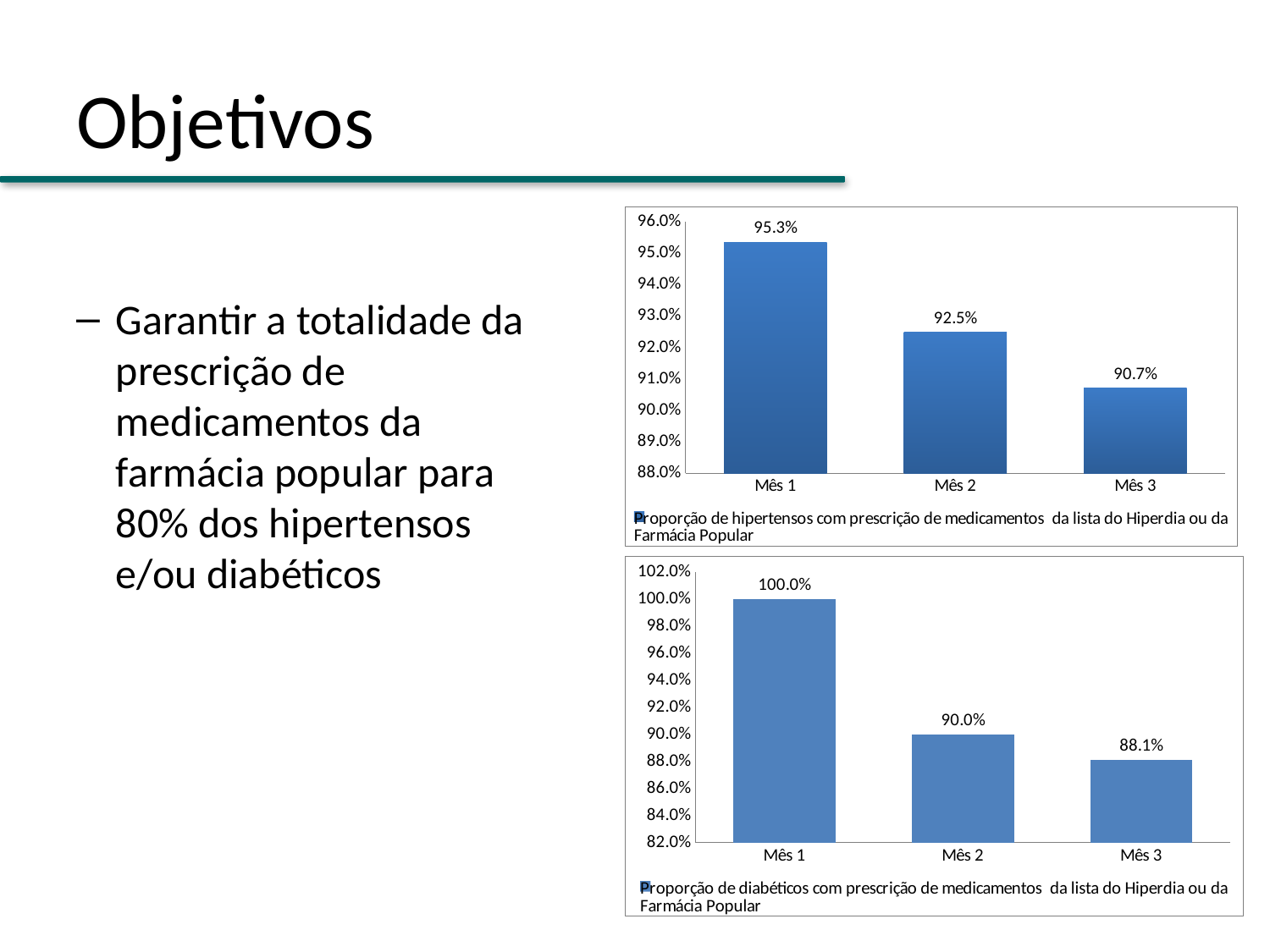
In the top chart (hipertensos), what is the value for Mês 1? 95.3% In the bottom chart (diabéticos), what is the value for Mês 2? 90.0% What kind of chart is the bottom chart (diabéticos)? bar chart In the bottom chart (diabéticos), which month has the lowest value? Mês 3 In the top chart (hipertensos), what is the value for Mês 3? 90.7% In the bottom chart (diabéticos), what is the value for Mês 3? 88.1% In the bottom chart (diabéticos), do the values rise or fall from Mês 1 to Mês 3? fall In the top chart (hipertensos), which month has the highest value? Mês 1 In the bottom chart (diabéticos), what is the difference between Mês 1 and Mês 3? 11.9% How many months are shown in the top chart (hipertensos)? 3 In the top chart (hipertensos), which is larger, Mês 2 or Mês 3? Mês 2 In the top chart (hipertensos), what is the difference between Mês 1 and Mês 2? 2.8%